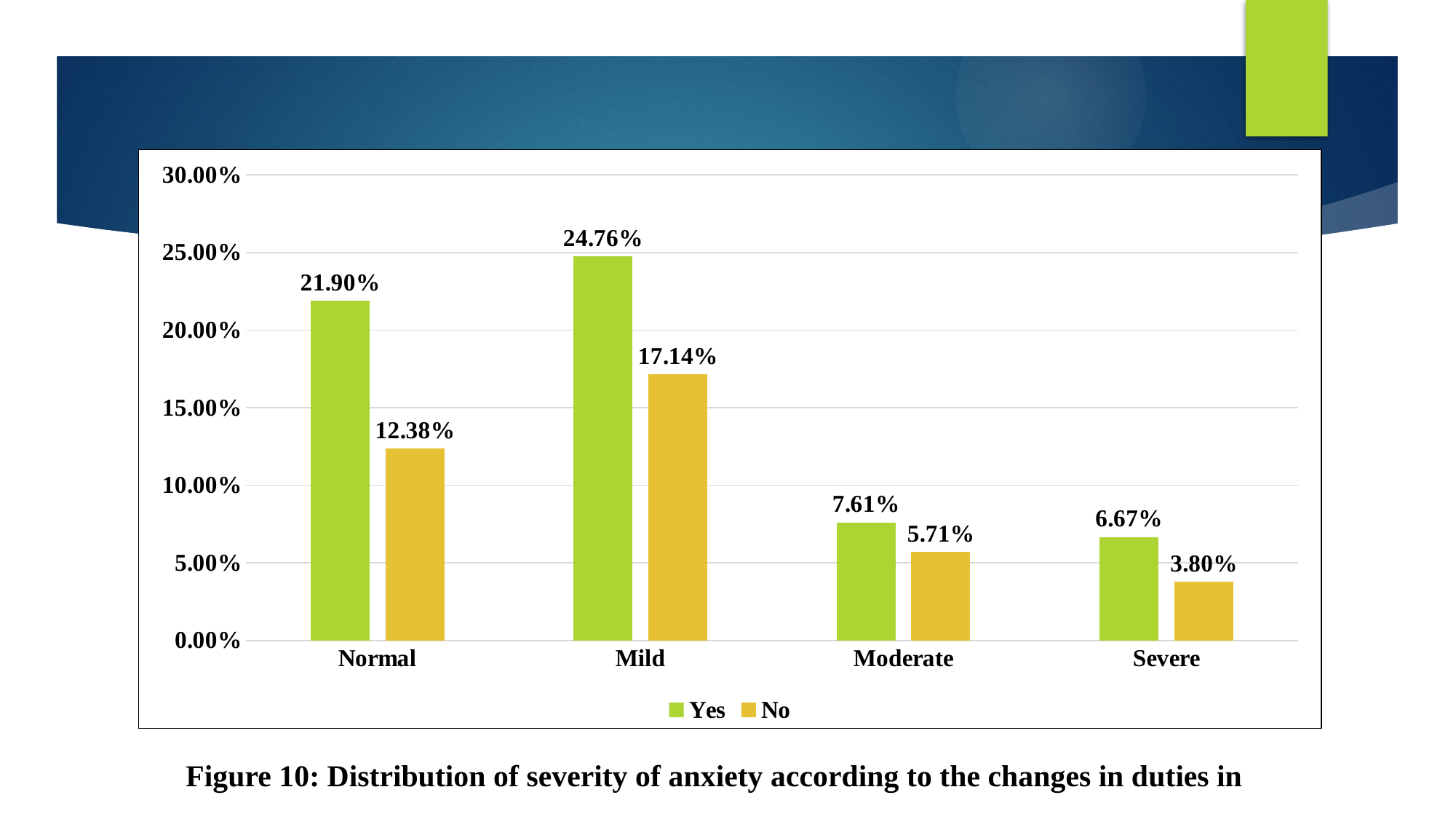
Which category has the lowest value for the No series? Severe How many categories are shown on the x axis? 4 Which is larger in the Moderate category, Yes or No? Yes Which category has the highest value for the Yes series? Mild What is the value for Yes in the Mild category? 24.76% What is the value for No in the Normal category? 12.38% What is the difference between the Yes and No values in the Mild category? 7.62% What kind of chart is shown on the slide? Bar chart Is the value for Yes in the Normal category greater or less than 20.00%? greater What is the value for No in the Severe category? 3.80% How many series does the legend list? 2 What colour are the bars for the Yes series? Green